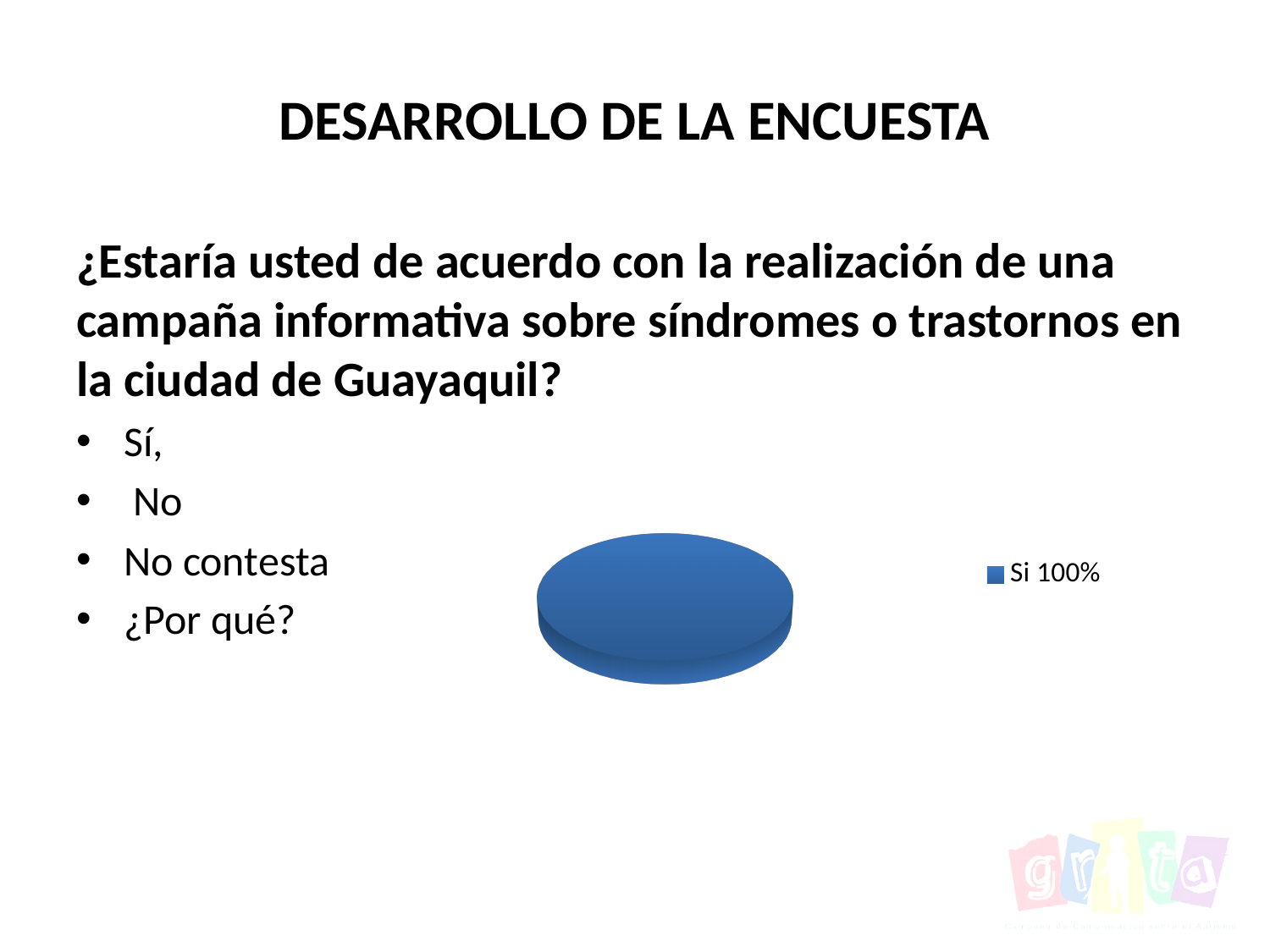
How many slices does the pie chart have? 1 What kind of chart is shown on the slide? pie chart How many entries does the chart's legend list? 1 What colour is the "Si" slice in the pie chart? blue Is the share for "Si" greater or less than 50%? greater What is the label of the only legend entry in the chart? Si 100% What share of the pie does the "Si" slice represent? 100%